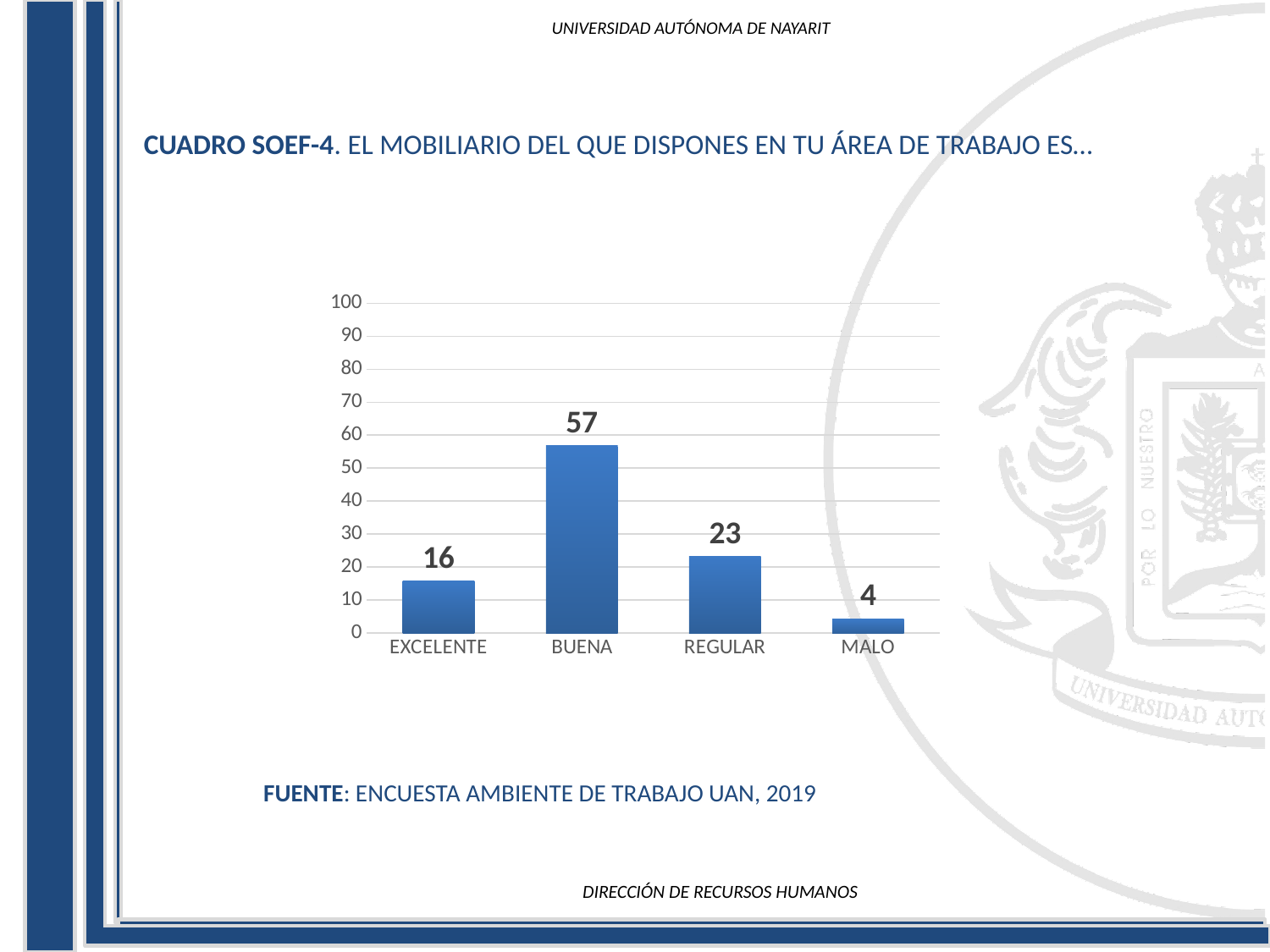
How many categories are shown on the x axis? 4 Which is larger, the value for EXCELENTE or the value for REGULAR? REGULAR What kind of chart is shown on the slide? Bar chart What is the value for REGULAR? 23 What is the value for BUENA? 57 What is the difference between the values for REGULAR and EXCELENTE? 7 What is the value for EXCELENTE? 16 What is the difference between the values for BUENA and REGULAR? 34 What is the source cited below the chart? ENCUESTA AMBIENTE DE TRABAJO UAN, 2019 Which category has the lowest value? MALO Which category has the highest value? BUENA What is the value for MALO? 4